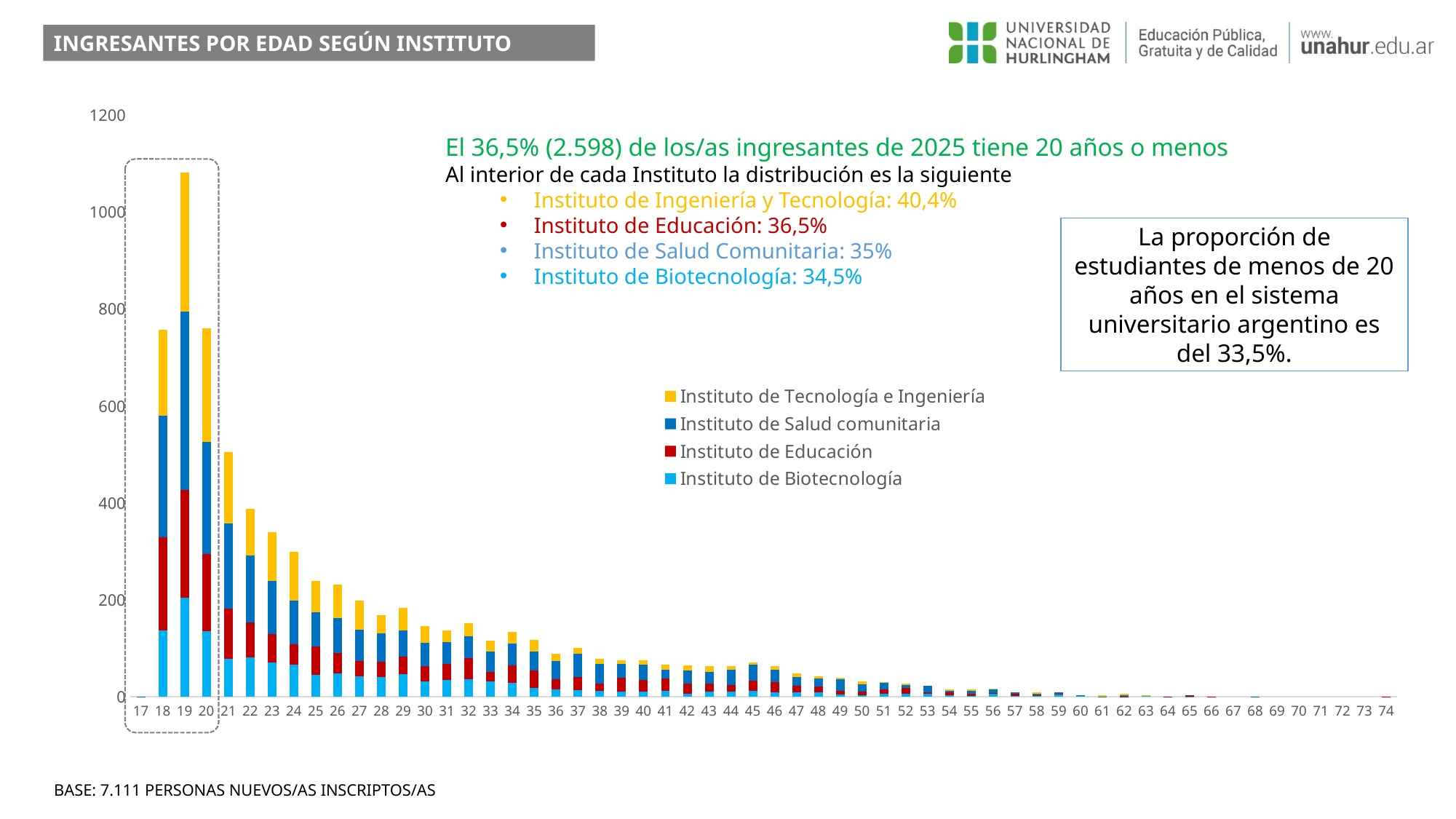
Is the total value for age 21 greater or less than 400? greater What is the title of the chart on the slide? INGRESANTES POR EDAD SEGÚN INSTITUTO How many series does the chart legend list? 4 Is the total value for age 19 greater or less than 1000? greater What kind of chart is shown on the slide? Stacked bar chart Which age has the tallest bar in the chart? 19 From age 19 onward, do the bar totals generally rise or fall as age increases? fall Which bar is taller, age 21 or age 22? 21 Which series is shown in yellow in the chart legend? Instituto de Tecnología e Ingeniería Is the total value for age 18 greater or less than 800? less Which bar is taller, age 19 or age 18? 19